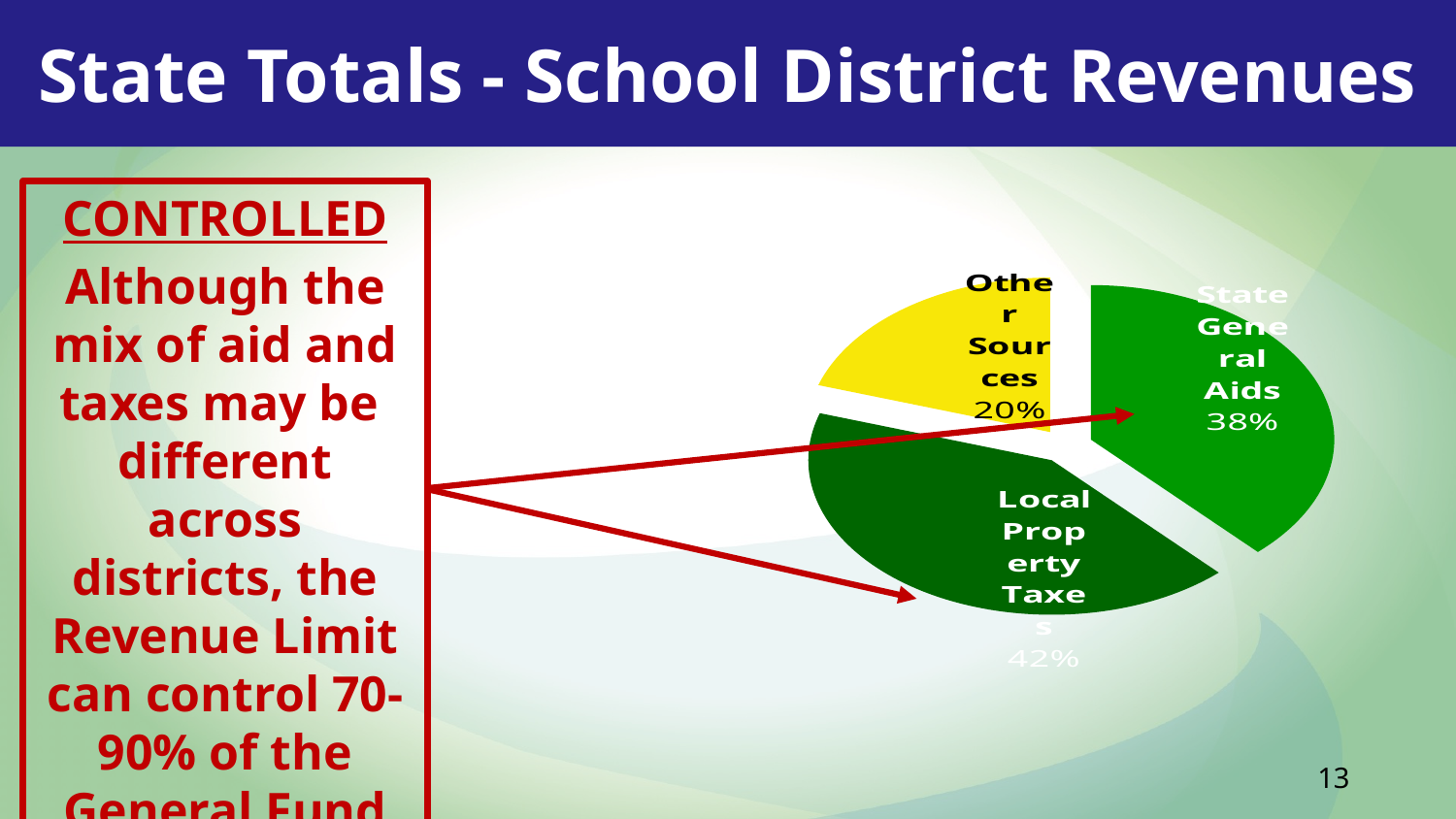
How many percentage points larger is the State General Aids share than the Other Sources share? 18 What share of school district revenues comes from Local Property Taxes? 42% What share of school district revenues comes from State General Aids? 38% What colour is the Other Sources slice? Yellow Which revenue source has the smallest share of the pie? Other Sources How many slices does the pie chart have? 3 What is the combined share of State General Aids and Local Property Taxes? 80% How many percentage points larger is the Local Property Taxes share than the State General Aids share? 4 Which revenue source has the largest share of the pie? Local Property Taxes What kind of chart is shown on the slide? Pie chart What share of school district revenues comes from Other Sources? 20% Which is larger, the share for State General Aids or the share for Other Sources? State General Aids